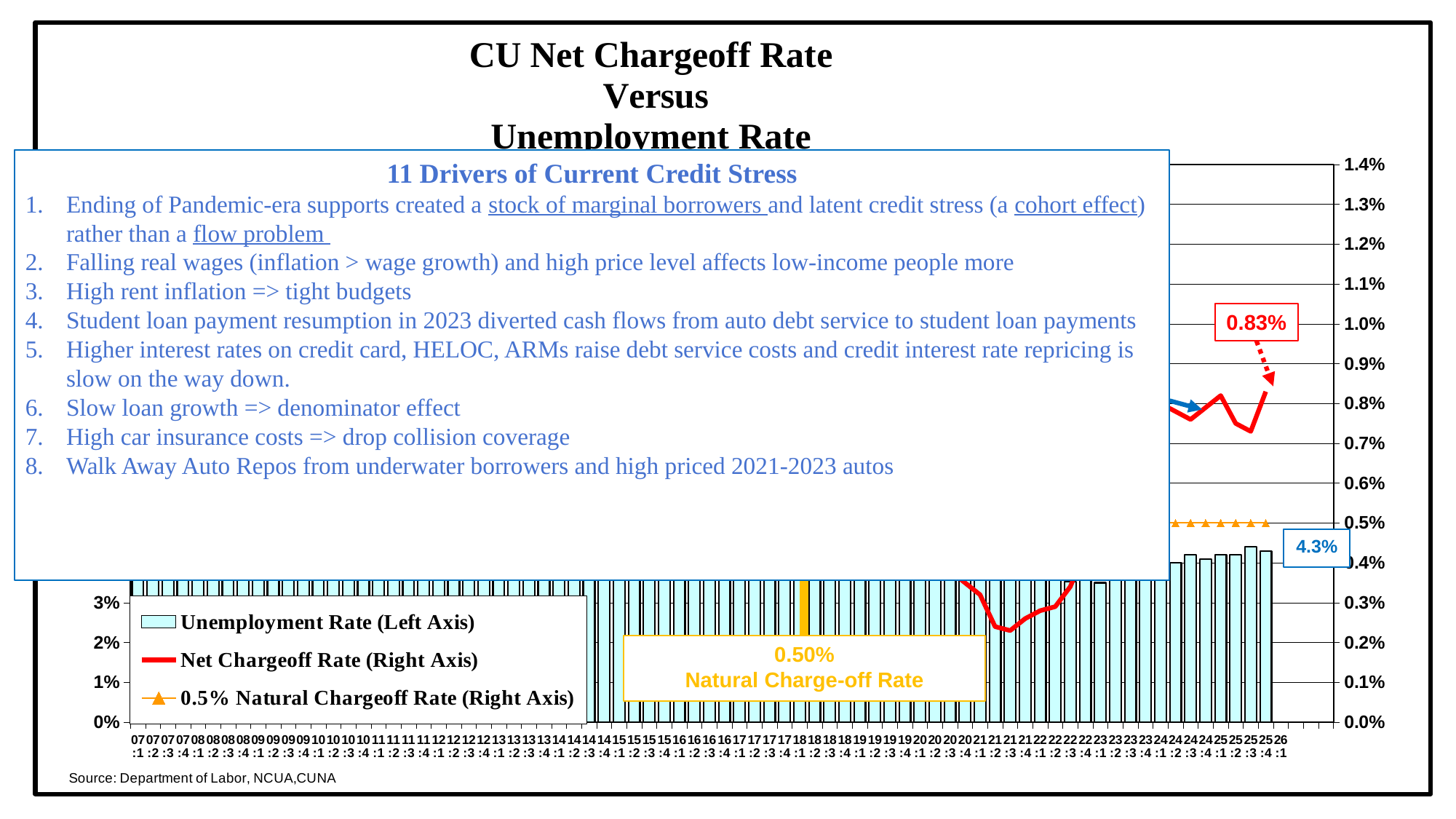
What is the highest value shown on the right-hand axis? 1.4% What net chargeoff rate value is labeled in the red box on the chart? 0.83% Which is larger, the labeled net chargeoff rate of 0.83% or the natural charge-off rate of 0.50%? 0.83% Do the unemployment rate bars rise or fall from 24:1 to 25:4? rise What kind of chart is shown on the slide? A combination bar and line chart How many series does the legend list? 3 What unemployment rate value is labeled in the blue box on the chart? 4.3% What is the difference between the labeled net chargeoff rate (0.83%) and the natural charge-off rate (0.50%)? 0.33% Is the net chargeoff rate at 21:3 greater or less than 0.5%? less Is the unemployment rate at 25:4 greater or less than 3%? greater What is the value of the natural charge-off rate shown on the chart? 0.50% Which series is plotted on the left axis according to the legend? Unemployment Rate